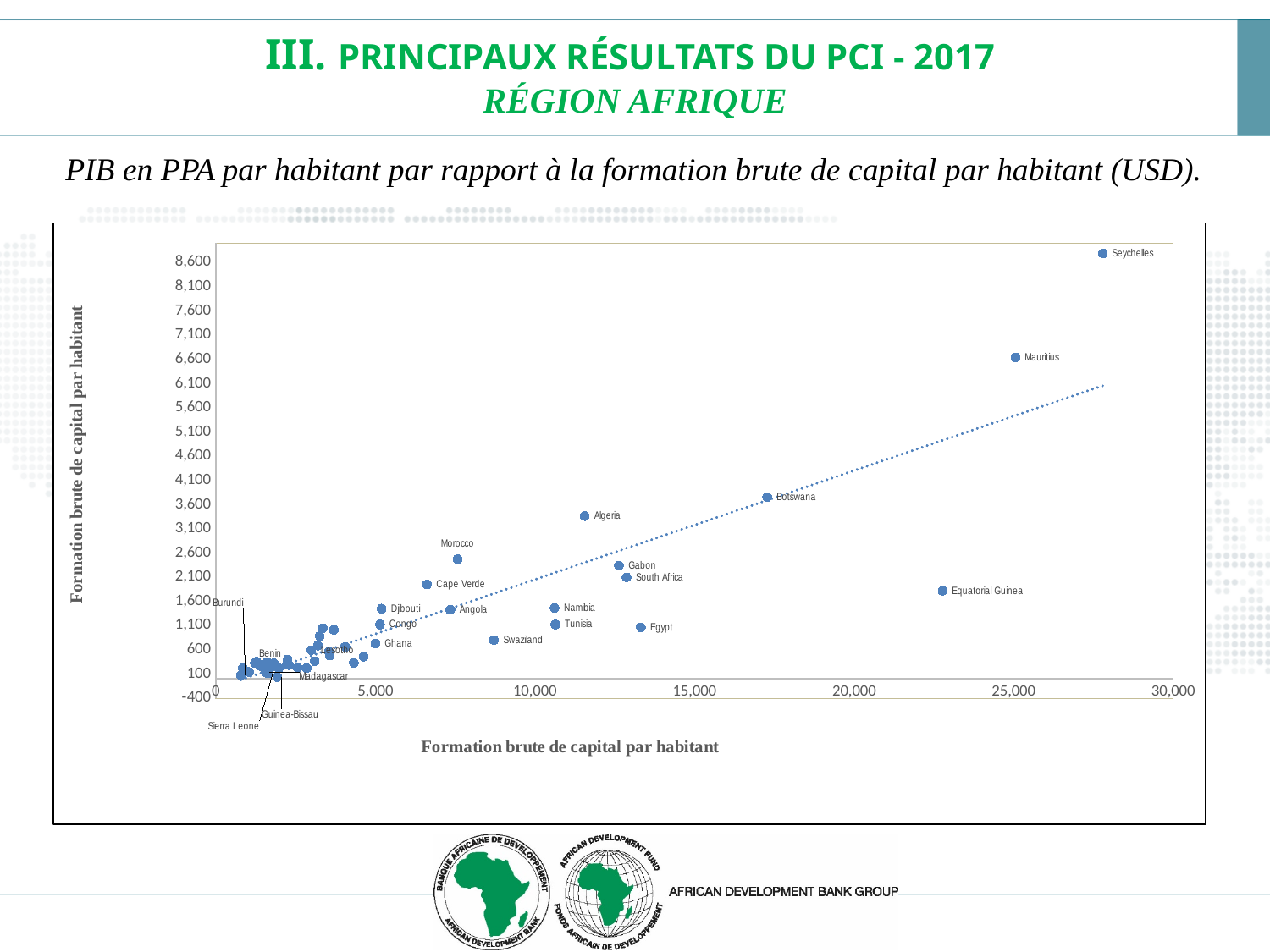
Is the vertical-axis value for Seychelles greater or less than 8,100? greater Is the horizontal-axis value for Mauritius greater or less than 20,000? greater Is the vertical-axis value for Algeria greater or less than 3,100? greater Do the plotted values generally rise or fall as the horizontal-axis value increases? rise What is the title of the horizontal axis? Formation brute de capital par habitant Which has the higher vertical-axis value, Morocco or Cape Verde? Morocco Which country has the highest value on the vertical axis? Seychelles Which has the higher vertical-axis value, Algeria or Botswana? Botswana What kind of chart is shown on the slide? scatter chart Which has the larger horizontal-axis value, Egypt or Tunisia? Egypt